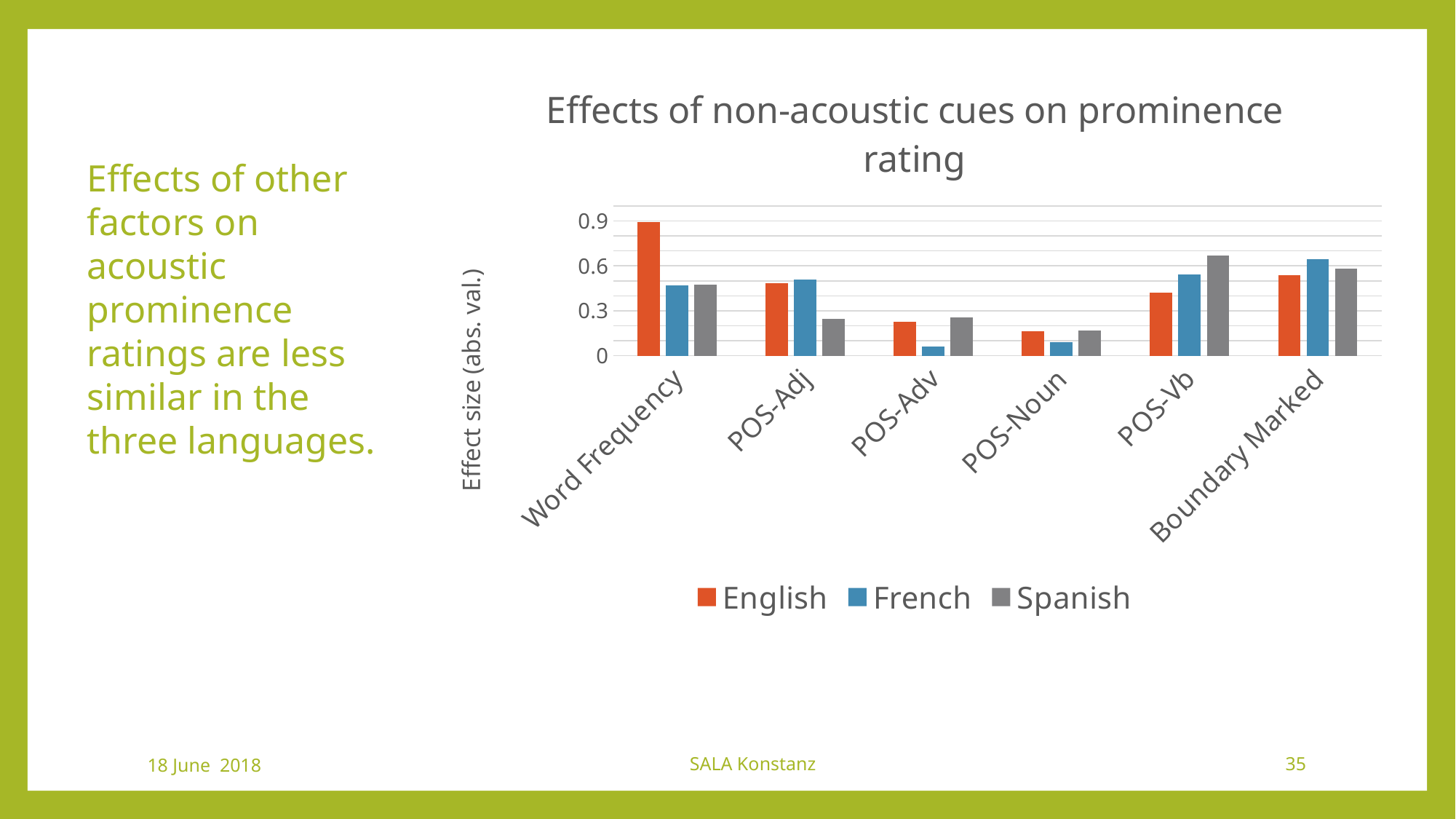
For Word Frequency, which is larger: the English value or the French value? English Is the French value for POS-Adv greater or less than 0.3? less Is the English value for Word Frequency greater or less than 0.6? greater Is the Spanish value for POS-Vb greater or less than 0.6? greater For which category is the English effect size highest? Word Frequency What is the label on the vertical axis of the chart? Effect size (abs. val.) For POS-Adv, which is larger: the French value or the Spanish value? Spanish What kind of chart is shown on the slide? bar chart How many series does the legend list? 3 For which category is the French effect size lowest? POS-Adv How many categories are shown on the x axis? 6 For which category is the Spanish effect size highest? POS-Vb